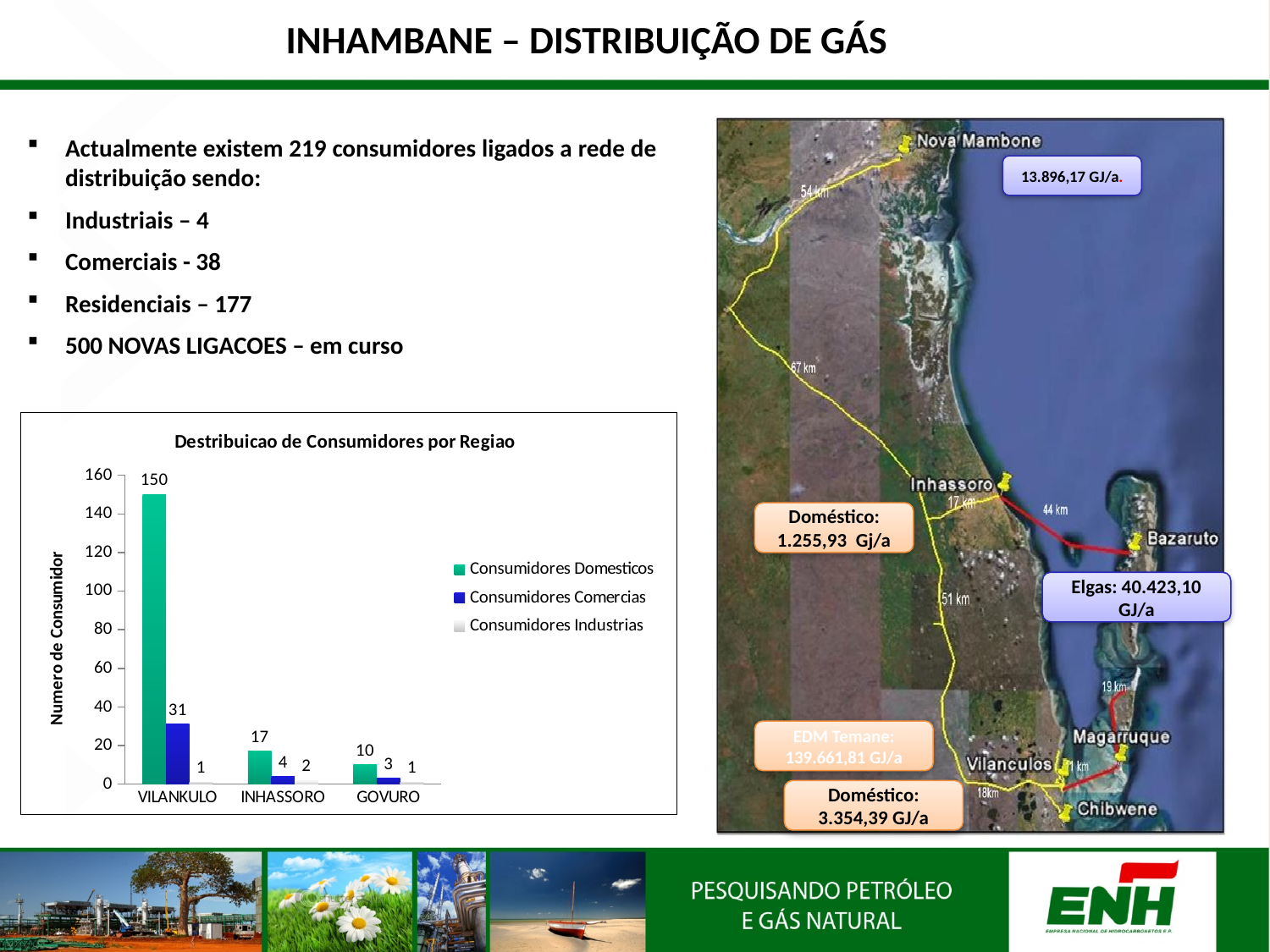
Which region has the lowest number of Consumidores Comercias? GOVURO What is the title of the chart? Destribuicao de Consumidores por Regiao How many series does the chart legend list? 3 What is the value for Consumidores Industrias in INHASSORO? 2 What kind of chart is shown on the slide? Bar chart What is the value for Consumidores Comercias in VILANKULO? 31 Which is larger: Consumidores Comercias in INHASSORO or Consumidores Comercias in GOVURO? INHASSORO How many regions are shown on the x axis of the chart? 3 What is the difference between Consumidores Domesticos in VILANKULO and INHASSORO? 133 What is the value for Consumidores Domesticos in GOVURO? 10 What is the value for Consumidores Domesticos in VILANKULO? 150 Which region has the highest number of Consumidores Domesticos? VILANKULO